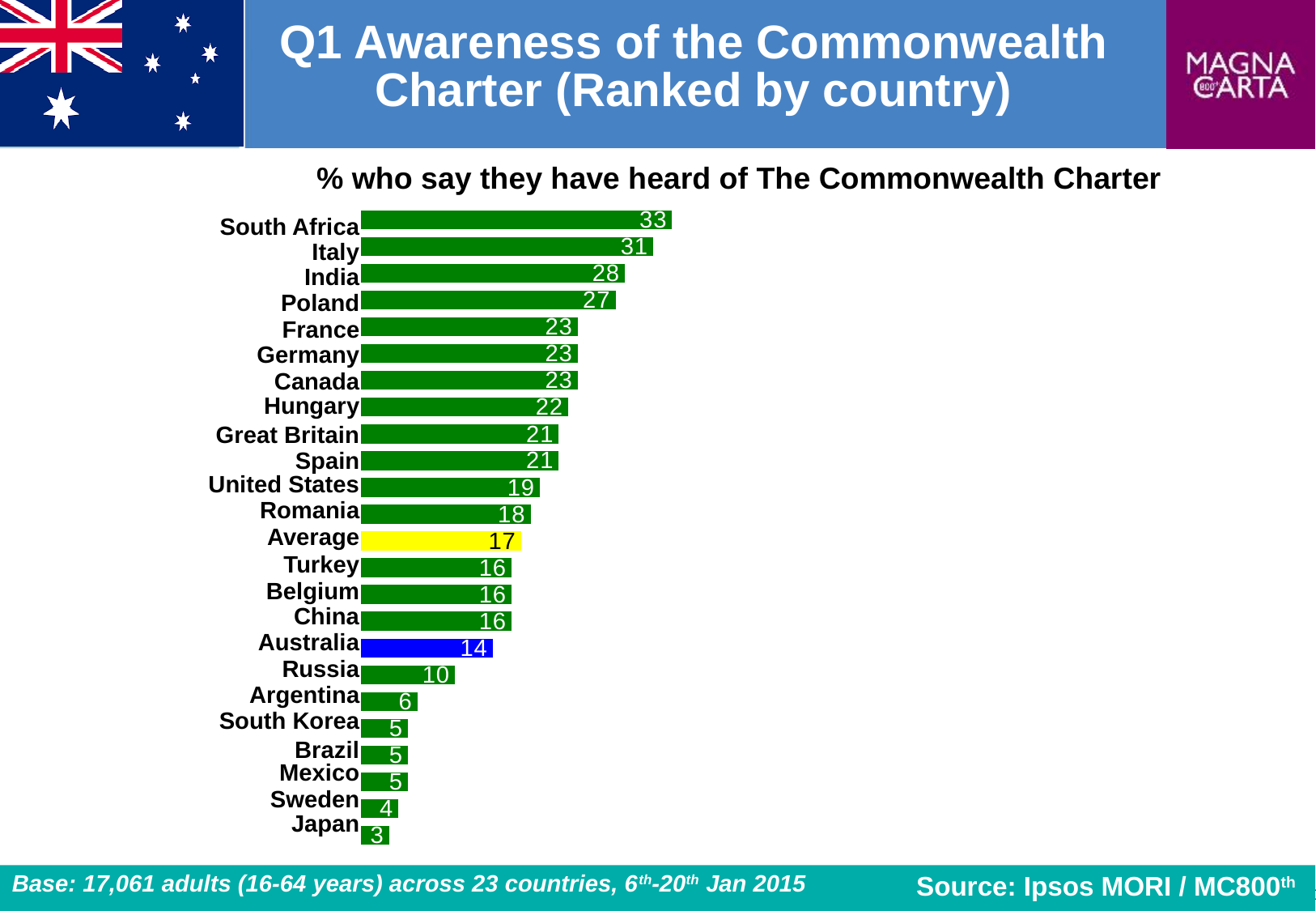
How many countries are shown on the chart, excluding the Average bar? 23 What type of chart is shown on the slide? Bar chart What is the value shown for Australia? 14 Which country has the lowest percentage who say they have heard of The Commonwealth Charter? Japan Which has a higher value, Russia or Turkey? Turkey Which bar on the chart is coloured yellow? Average What is the difference between the values for Italy and India? 3 What is the Average value shown on the chart? 17 What percentage of people in South Africa say they have heard of The Commonwealth Charter? 33 Which country has the highest percentage who say they have heard of The Commonwealth Charter? South Africa Which has a higher value, Poland or Hungary? Poland How much higher is the value for Great Britain than the value for Australia? 7